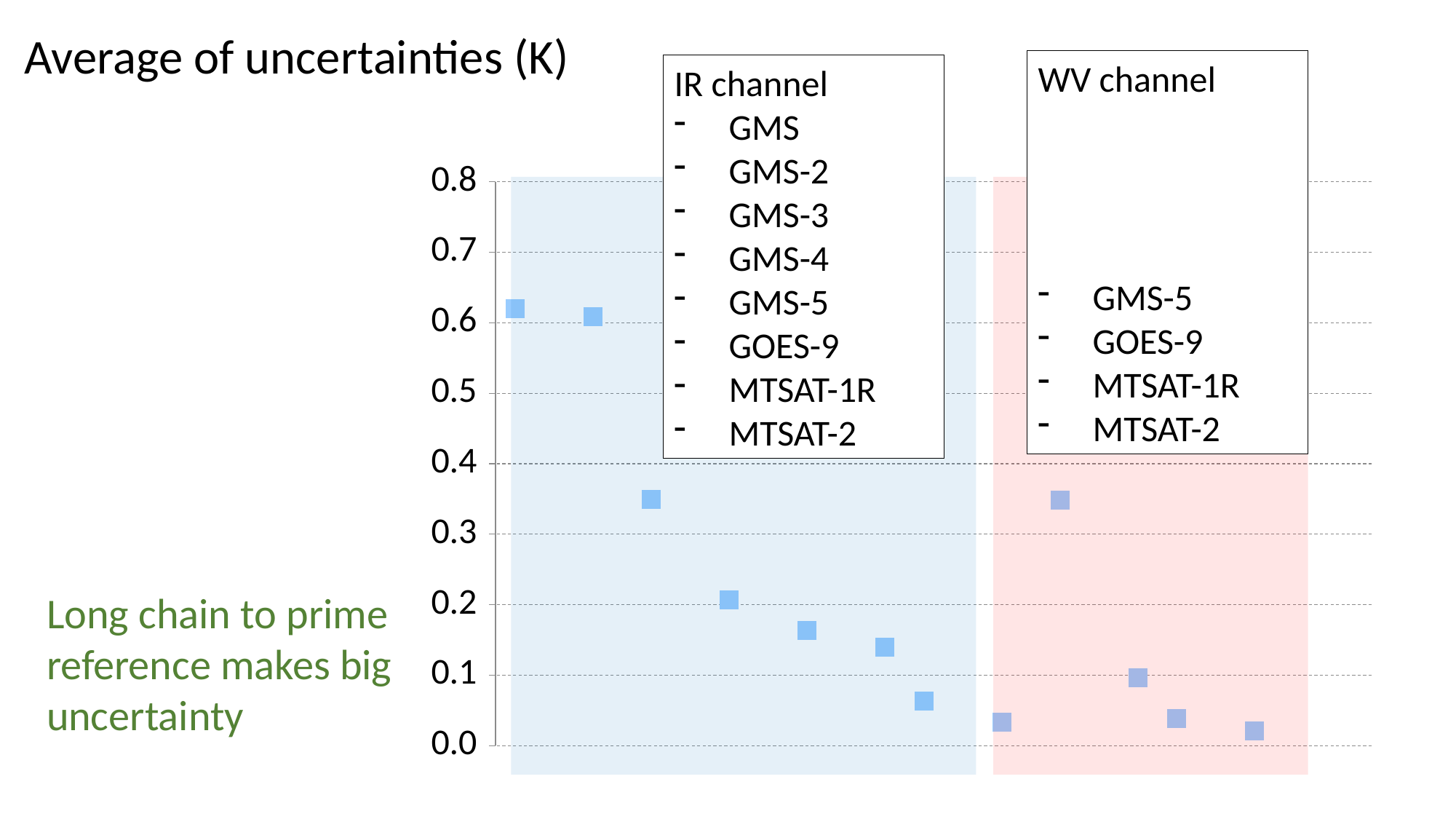
What kind of chart is shown on the slide? scatter chart Is the value of the leftmost point in the WV channel region greater or less than 0.1? less Is the value of the leftmost point in the IR channel region greater or less than 0.5? greater What is the title of the chart? Average of uncertainties (K) Which region contains the highest plotted point, the IR channel region or the WV channel region? IR channel region Do the values in the IR channel region generally rise or fall from left to right? fall Is the value of the lowest point in the IR channel region greater or less than 0.1? less What is the highest value shown on the vertical axis of the chart? 0.8